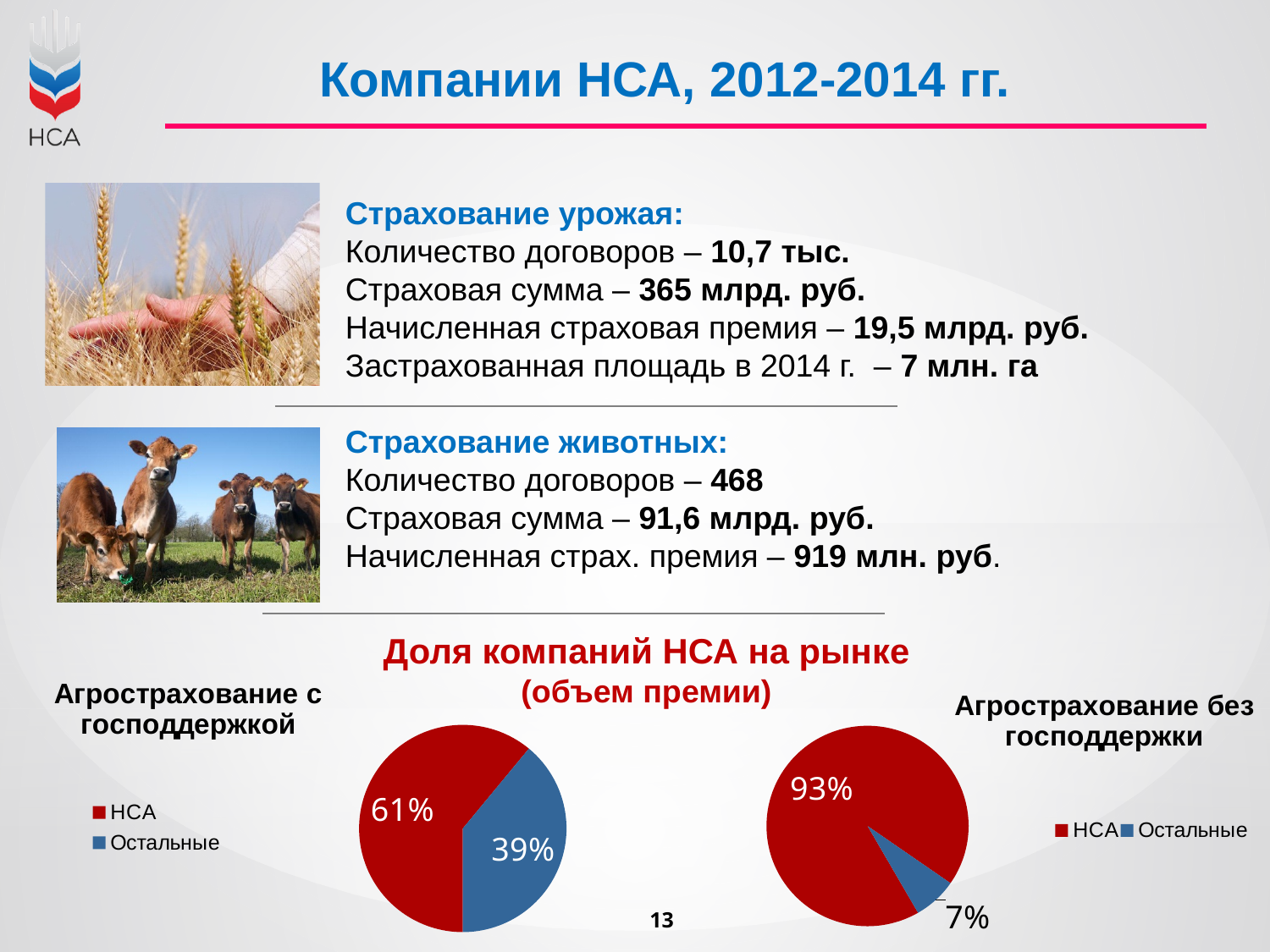
What colour represents НСА in the pie charts? Red In the 'Агрострахование без господдержки' pie chart, what share does НСА hold? 93% What type of chart is used to show 'Доля компаний НСА на рынке (объем премии)'? Pie chart In the 'Агрострахование с господдержкой' pie chart, which slice is the largest? НСА In the 'Агрострахование с господдержкой' pie chart, what share does НСА hold? 61% In the 'Агрострахование с господдержкой' pie chart, what share does Остальные hold? 39% In the 'Агрострахование без господдержки' pie chart, what is the difference between the НСА share and the Остальные share? 86% In the 'Агрострахование без господдержки' pie chart, what share does Остальные hold? 7% In the 'Агрострахование с господдержкой' pie chart, what is the difference between the НСА share and the Остальные share? 22% How many slices does the 'Агрострахование с господдержкой' pie chart have? 2 Is the НСА share larger in the 'Агрострахование с господдержкой' chart or in the 'Агрострахование без господдержки' chart? Агрострахование без господдержки In the 'Агрострахование без господдержки' pie chart, which slice is the smallest? Остальные